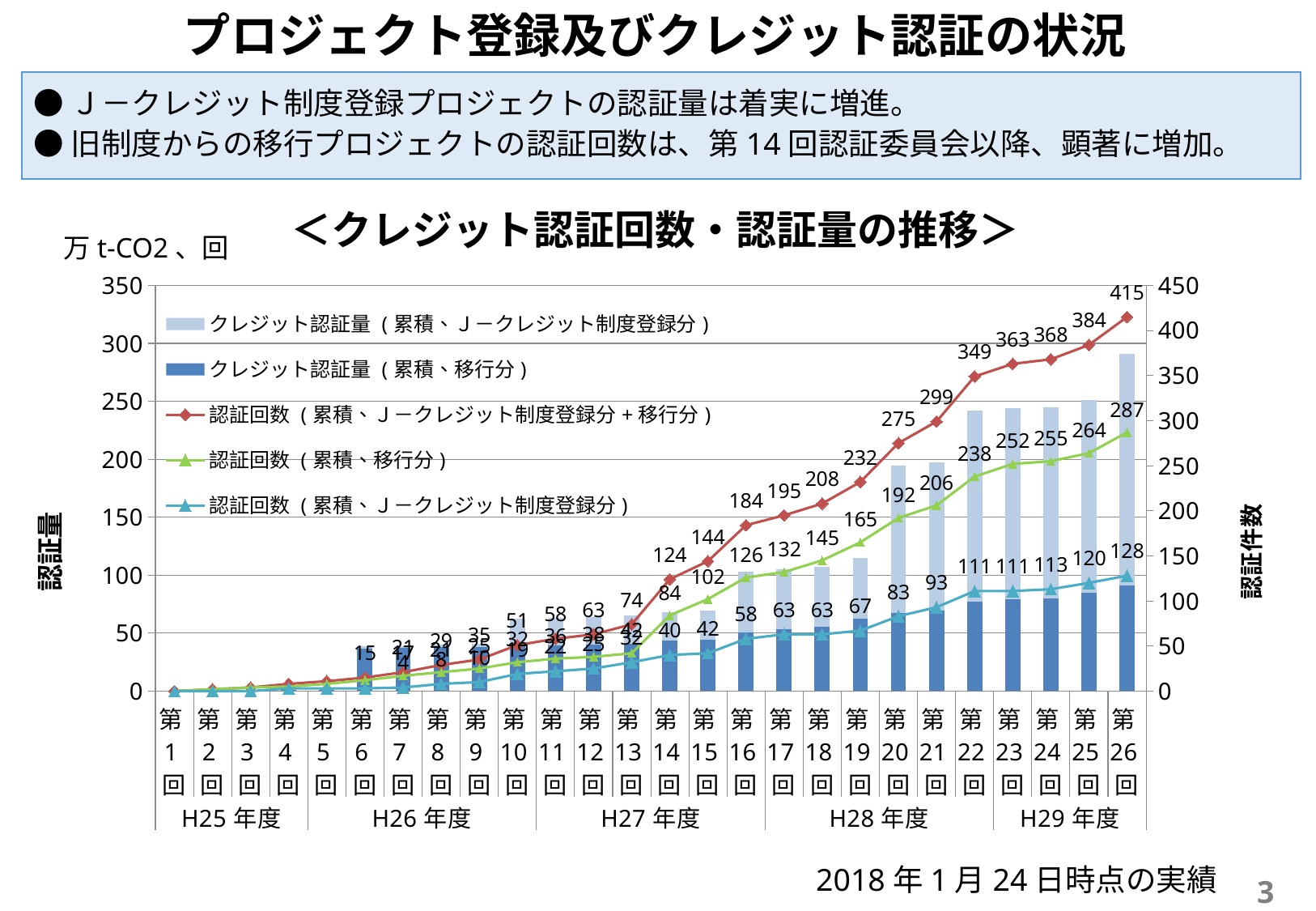
What is the value of 認証回数（累積、移行分） at 第22回? 238 What kind of chart is this? Combination of stacked bar chart and line chart How many series does the legend list? 5 How many 回 categories are shown on the x axis? 26 At which 回 does 認証回数（累積、Ｊ－クレジット制度登録分＋移行分） reach its highest value? 第26回 What is the difference between 認証回数（累積、移行分） and 認証回数（累積、Ｊ－クレジット制度登録分） at 第26回? 159 What is the value of 認証回数（累積、Ｊ－クレジット制度登録分＋移行分） at 第26回? 415 What is the value of 認証回数（累積、Ｊ－クレジット制度登録分＋移行分） at 第14回? 124 What is the value of 認証回数（累積、Ｊ－クレジット制度登録分） at 第20回? 83 Which is larger at 第21回: 認証回数（累積、移行分） or 認証回数（累積、Ｊ－クレジット制度登録分）? 認証回数（累積、移行分） What is the difference between 認証回数（累積、Ｊ－クレジット制度登録分＋移行分） at 第26回 and at 第25回? 31 Is the total height of the stacked bar at 第26回 greater or less than 250 on the left axis? greater